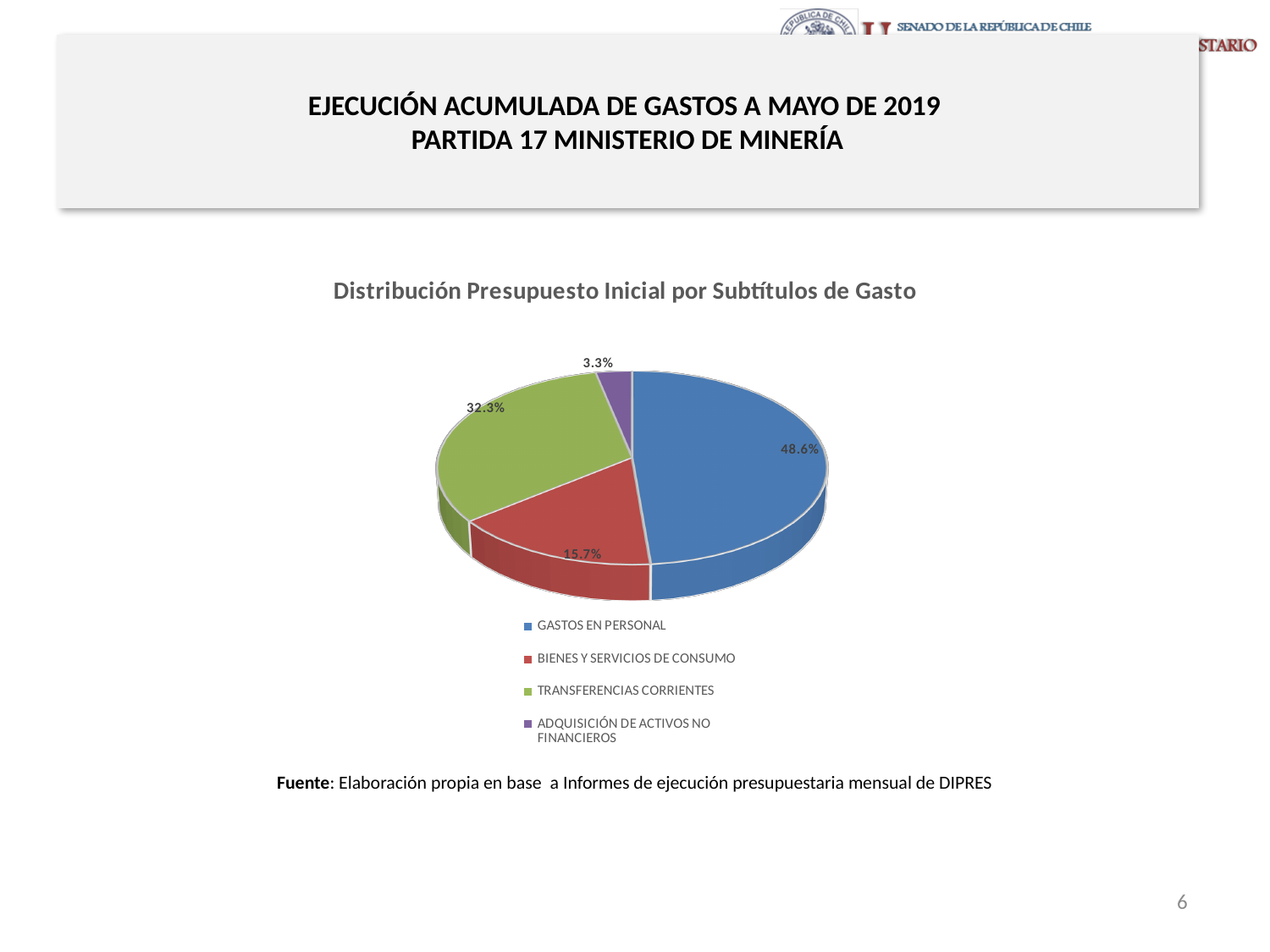
What share of the pie does ADQUISICIÓN DE ACTIVOS NO FINANCIEROS represent? 3.3% Which category has the smallest slice of the pie? ADQUISICIÓN DE ACTIVOS NO FINANCIEROS What kind of chart is shown on the slide? Pie chart Which is larger, the share for BIENES Y SERVICIOS DE CONSUMO or the share for TRANSFERENCIAS CORRIENTES? TRANSFERENCIAS CORRIENTES What share of the pie does BIENES Y SERVICIOS DE CONSUMO represent? 15.7% What colour is the slice for BIENES Y SERVICIOS DE CONSUMO? Red What share of the pie does GASTOS EN PERSONAL represent? 48.6% Which category has the largest slice of the pie? GASTOS EN PERSONAL What is the difference in percentage points between GASTOS EN PERSONAL and TRANSFERENCIAS CORRIENTES? 16.3 How many categories does the pie chart show? 4 What is the title of the chart? Distribución Presupuesto Inicial por Subtítulos de Gasto